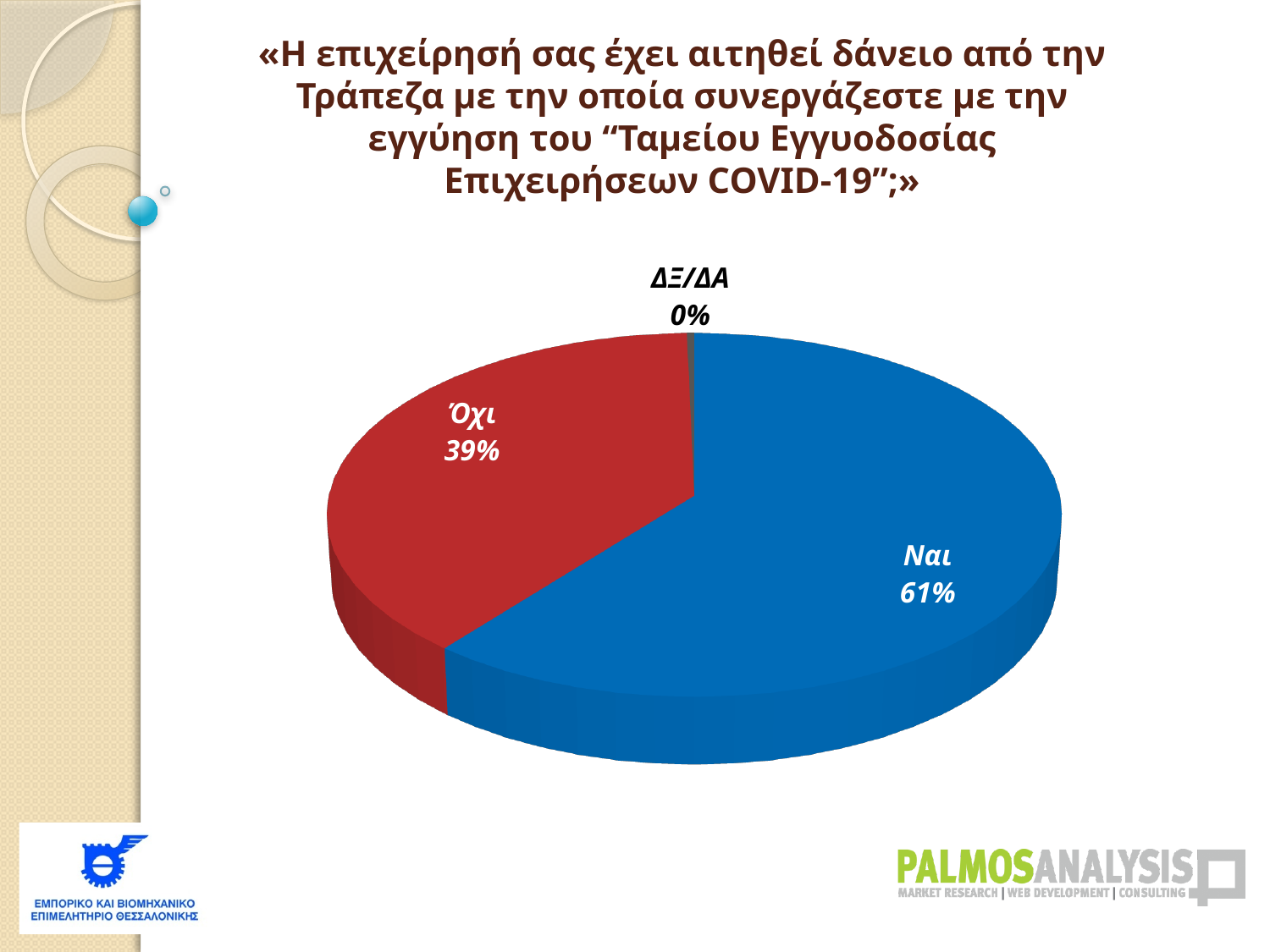
Which is larger, the share for Ναι or the share for Όχι? Ναι What colour is the Ναι slice? blue What kind of chart is shown on the slide? pie chart What colour is the Όχι slice? red What is the difference in percentage points between Ναι and Όχι? 22 What percentage of respondents answered Όχι? 39% Which category has the largest share of the pie? Ναι How many categories are shown in the pie chart? 3 Is the share for Ναι greater or less than 50%? greater What percentage is shown for ΔΞ/ΔΑ? 0% Which category has the smallest share of the pie? ΔΞ/ΔΑ What percentage of respondents answered Ναι? 61%